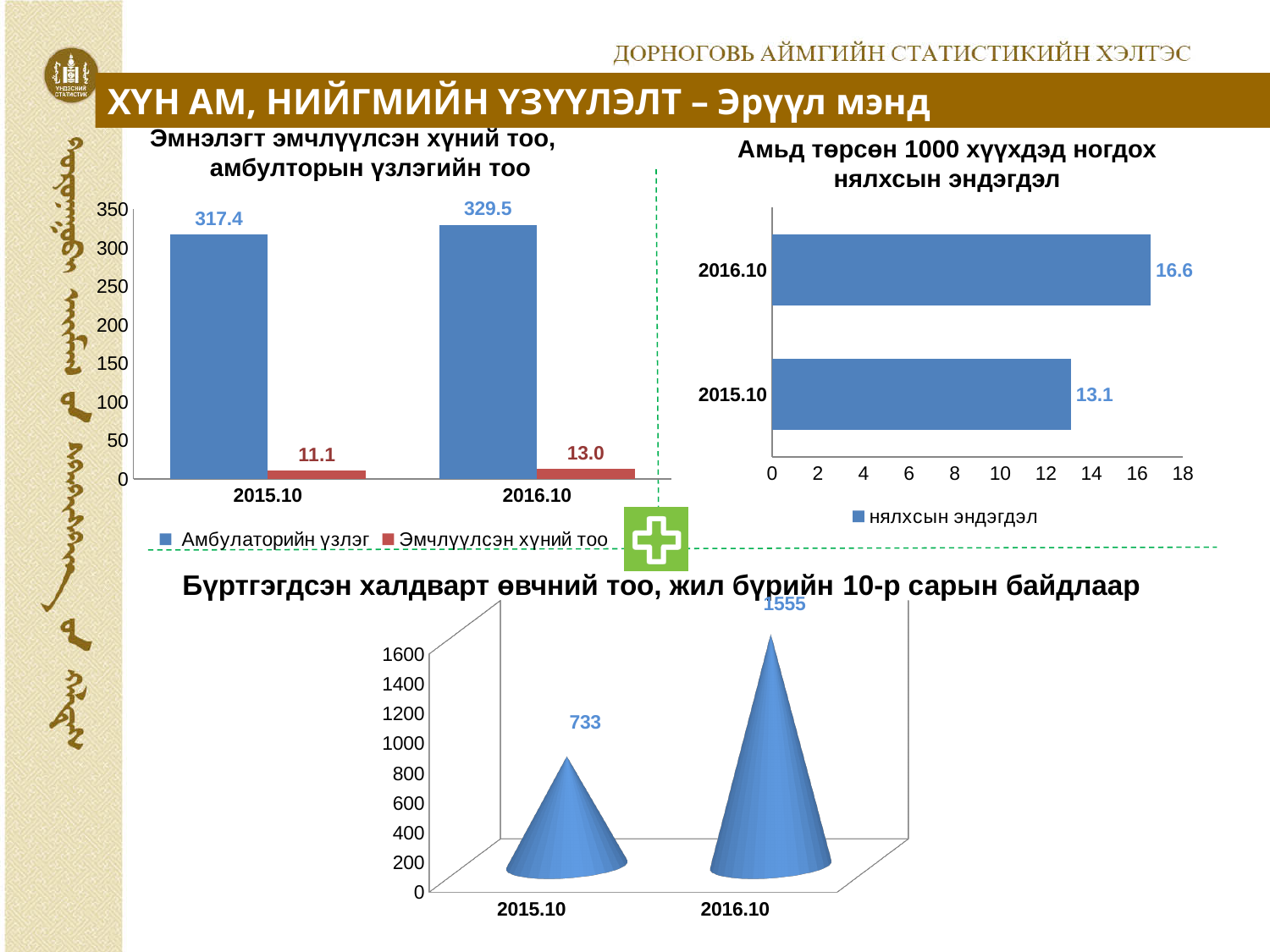
In the top-right chart 'Амьд төрсөн 1000 хүүхдэд ногдох нялхсын эндэгдэл', which period has the lower value? 2015.10 In the top-left chart 'Эмнэлэгт эмчлүүлсэн хүний тоо, амбулторын үзлэгийн тоо', what is the value of Амбулаторийн үзлэг for 2016.10? 329.5 In the top-left chart 'Эмнэлэгт эмчлүүлсэн хүний тоо, амбулторын үзлэгийн тоо', by how much did Амбулаторийн үзлэг increase from 2015.10 to 2016.10? 12.1 In the top-left chart 'Эмнэлэгт эмчлүүлсэн хүний тоо, амбулторын үзлэгийн тоо', does Эмчлүүлсэн хүний тоо rise or fall from 2015.10 to 2016.10? rise What kind of chart is the top-right chart 'Амьд төрсөн 1000 хүүхдэд ногдох нялхсын эндэгдэл'? bar chart In the top-right chart 'Амьд төрсөн 1000 хүүхдэд ногдох нялхсын эндэгдэл', what is the value for 2016.10? 16.6 How many categories are shown on the x axis of the bottom chart 'Бүртгэгдсэн халдварт өвчний тоо, жил бүрийн 10-р сарын байдлаар'? 2 In the bottom chart 'Бүртгэгдсэн халдварт өвчний тоо, жил бүрийн 10-р сарын байдлаар', what is the difference between the 2016.10 and 2015.10 values? 822 How many series does the legend of the top-left chart 'Эмнэлэгт эмчлүүлсэн хүний тоо, амбулторын үзлэгийн тоо' list? 2 In the bottom chart 'Бүртгэгдсэн халдварт өвчний тоо, жил бүрийн 10-р сарын байдлаар', what is the value for 2015.10? 733 In the top-right chart 'Амьд төрсөн 1000 хүүхдэд ногдох нялхсын эндэгдэл', what is the difference between the 2016.10 and 2015.10 values? 3.5 In the top-left chart 'Эмнэлэгт эмчлүүлсэн хүний тоо, амбулторын үзлэгийн тоо', what is the value of Эмчлүүлсэн хүний тоо for 2015.10? 11.1